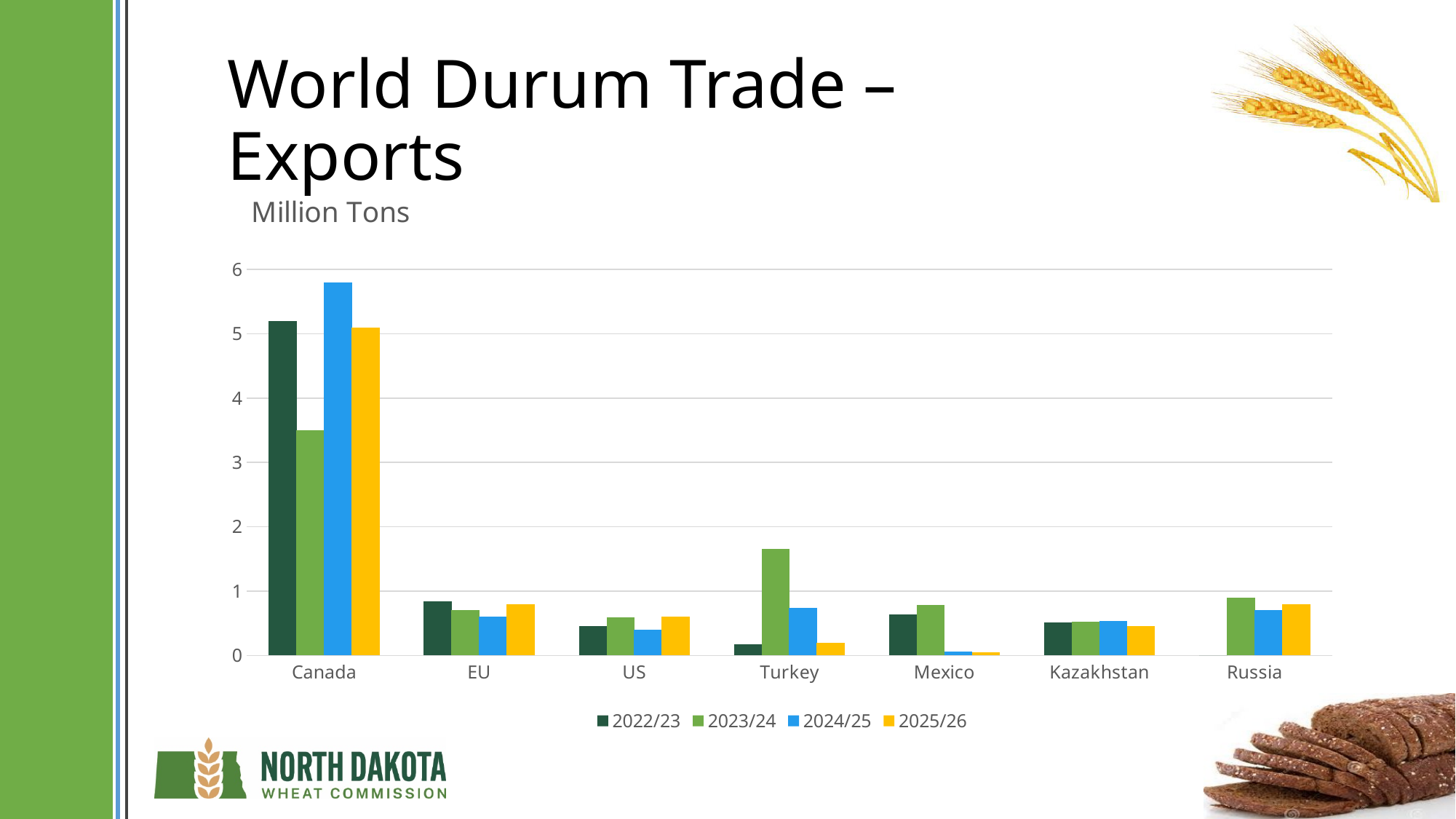
For Turkey, which is larger: the 2023/24 value or the 2024/25 value? 2023/24 How many countries/regions are shown on the x axis of the chart? 7 Is the value for Turkey in 2023/24 greater or less than 1? greater For Mexico, which is larger: the 2022/23 value or the 2024/25 value? 2022/23 Is the value for Canada in 2024/25 greater or less than 5? greater What colour represents the 2025/26 series in the legend? yellow How many series does the legend list? 4 Which country has the highest durum exports in 2024/25? Canada What unit is shown above the chart? Million Tons Which year has the lowest export value for Canada? 2023/24 What kind of chart is shown on the slide? bar chart Is the value for Canada in 2023/24 greater or less than 4? less